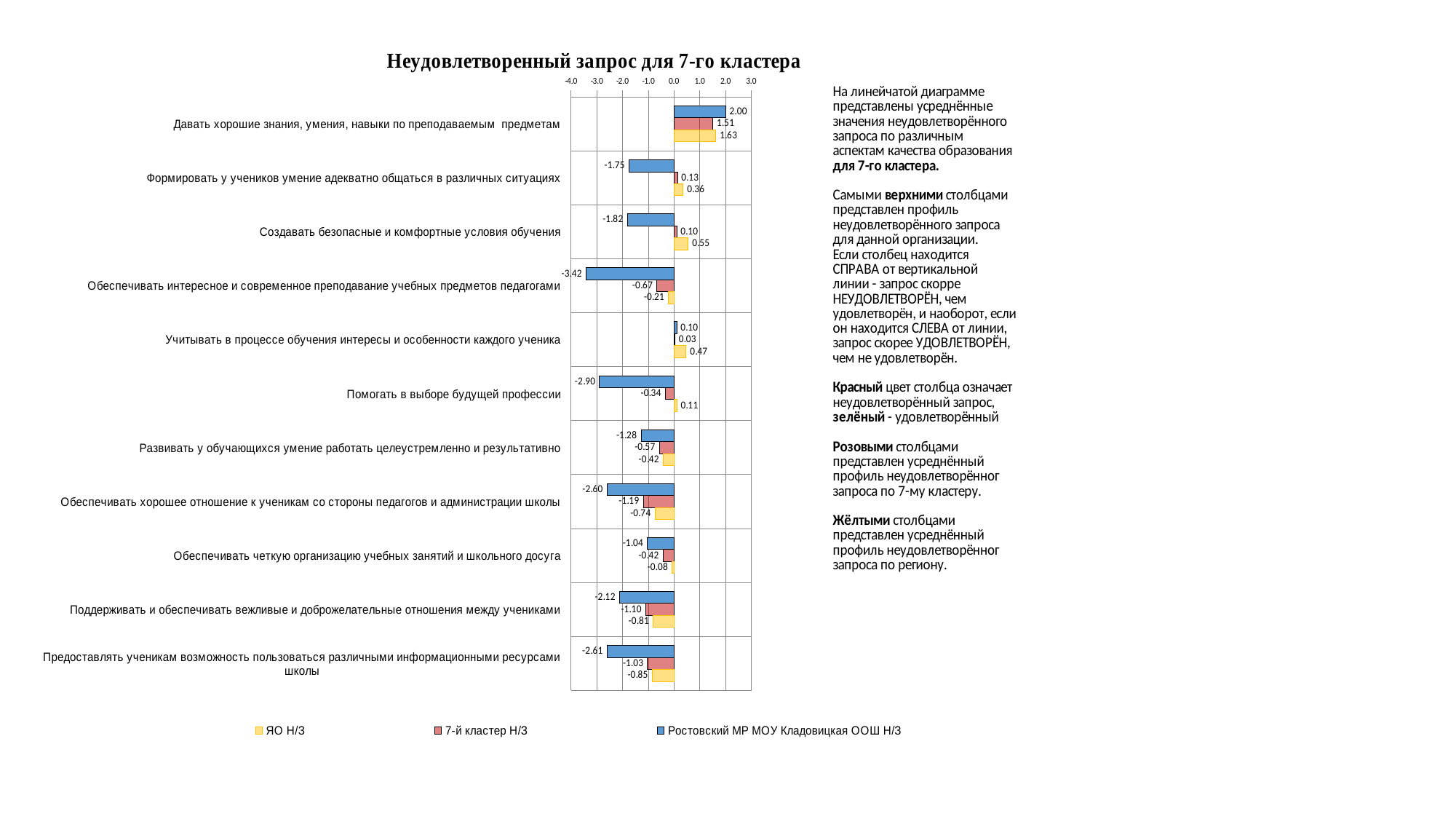
What is the value for "Ростовский МР МОУ Кладовицкая ООШ Н/З" in the category "Давать хорошие знания, умения, навыки по преподаваемым предметам"? 2.00 In which category does "ЯО Н/З" have its highest value? Давать хорошие знания, умения, навыки по преподаваемым предметам What is the value for "ЯО Н/З" in the category "Создавать безопасные и комфортные условия обучения"? 0.55 What kind of chart is shown on the slide? Bar chart What is the difference between the "ЯО Н/З" value and the "7-й кластер Н/З" value in the category "Давать хорошие знания, умения, навыки по преподаваемым предметам"? 0.12 What is the value for "7-й кластер Н/З" in the category "Обеспечивать хорошее отношение к ученикам со стороны педагогов и администрации школы"? -1.19 What is the title of the chart? Неудовлетворенный запрос для 7-го кластера What is the value for "7-й кластер Н/З" in the category "Учитывать в процессе обучения интересы и особенности каждого ученика"? 0.03 In the category "Помогать в выборе будущей профессии", which series has the larger value: "ЯО Н/З" or "Ростовский МР МОУ Кладовицкая ООШ Н/З"? ЯО Н/З In which category does "Ростовский МР МОУ Кладовицкая ООШ Н/З" have its lowest value? Обеспечивать интересное и современное преподавание учебных предметов педагогами How many series does the legend list? 3 How many categories are plotted on the chart? 11